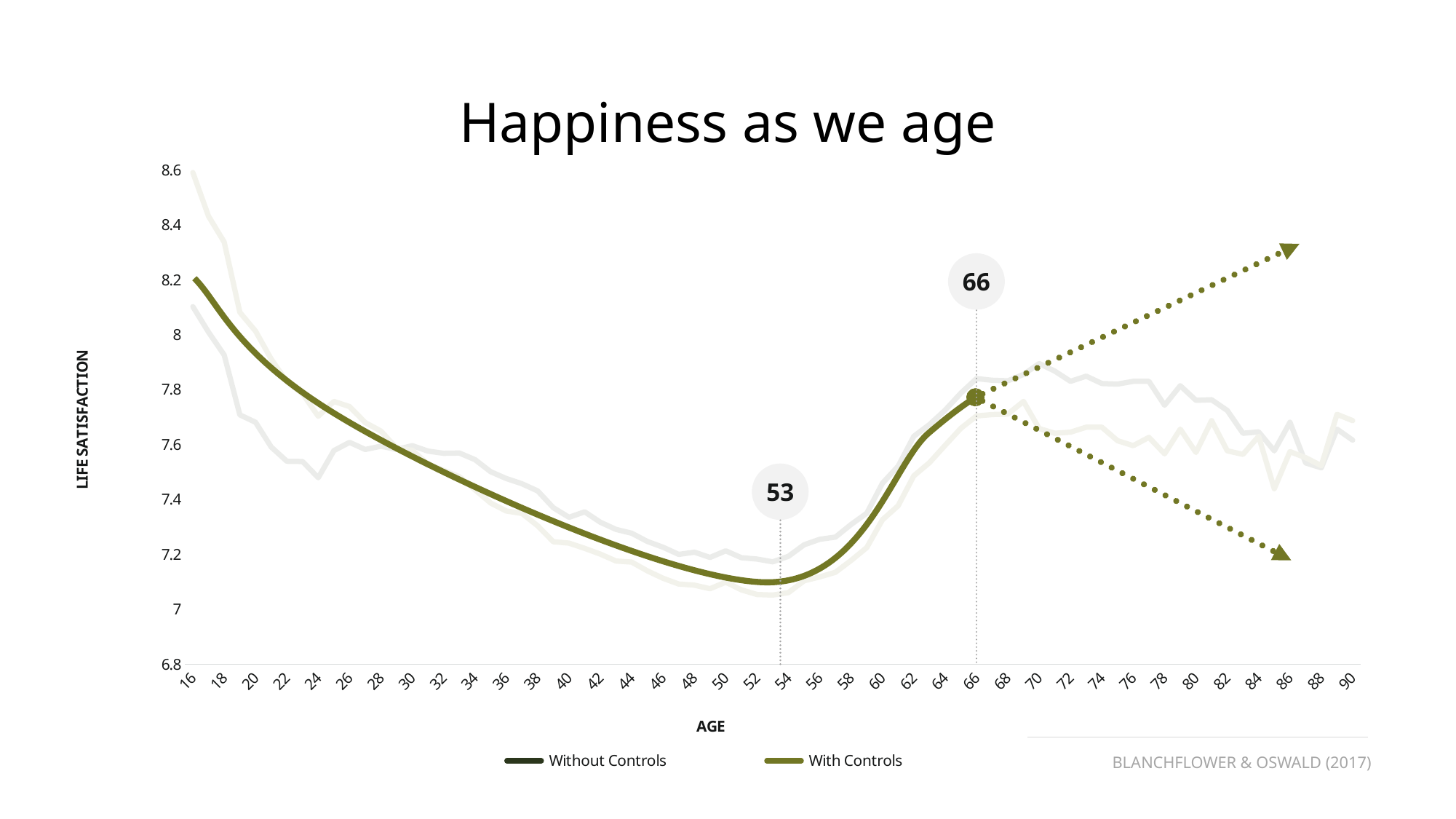
What is the title of the chart? Happiness as we age Is life satisfaction at age 66 greater or less than 7.6? greater Is life satisfaction at age 16 greater or less than 8? greater How many series does the legend list? 2 Which is higher, life satisfaction at age 16 or at age 66? age 16 What are the two series named in the legend? Without Controls, With Controls What is the lowest value shown on the vertical axis? 6.8 Does life satisfaction rise or fall between age 53 and age 66? rise Does life satisfaction rise or fall between age 16 and age 53? fall What kind of chart is shown on the slide? line chart Is life satisfaction at age 53 greater or less than 7.2? less At which age does life satisfaction reach its lowest point on the chart? 53